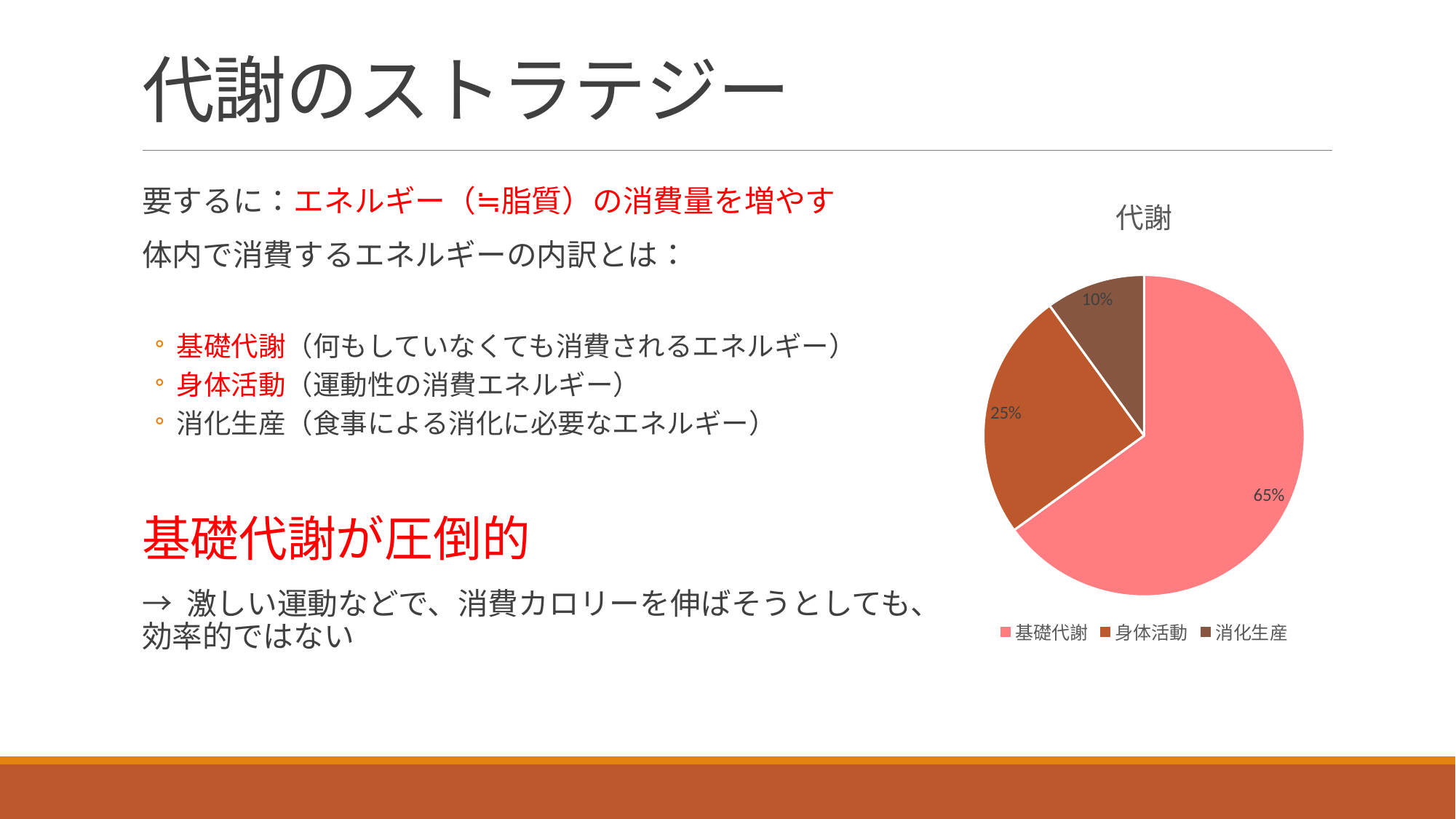
How many categories does the pie chart have? 3 Which is larger, the 身体活動 slice or the 消化生産 slice? 身体活動 What percentage does the 身体活動 slice represent? 25% What is the difference in percentage points between 基礎代謝 and 身体活動? 40 What type of chart is shown on the slide? Pie chart Which category has the smallest slice of the pie? 消化生産 How many entries does the legend list? 3 What is the difference in percentage points between 身体活動 and 消化生産? 15 What percentage does the 基礎代謝 slice represent? 65% Which category has the largest slice of the pie? 基礎代謝 What percentage does the 消化生産 slice represent? 10% What is the title of the chart? 代謝